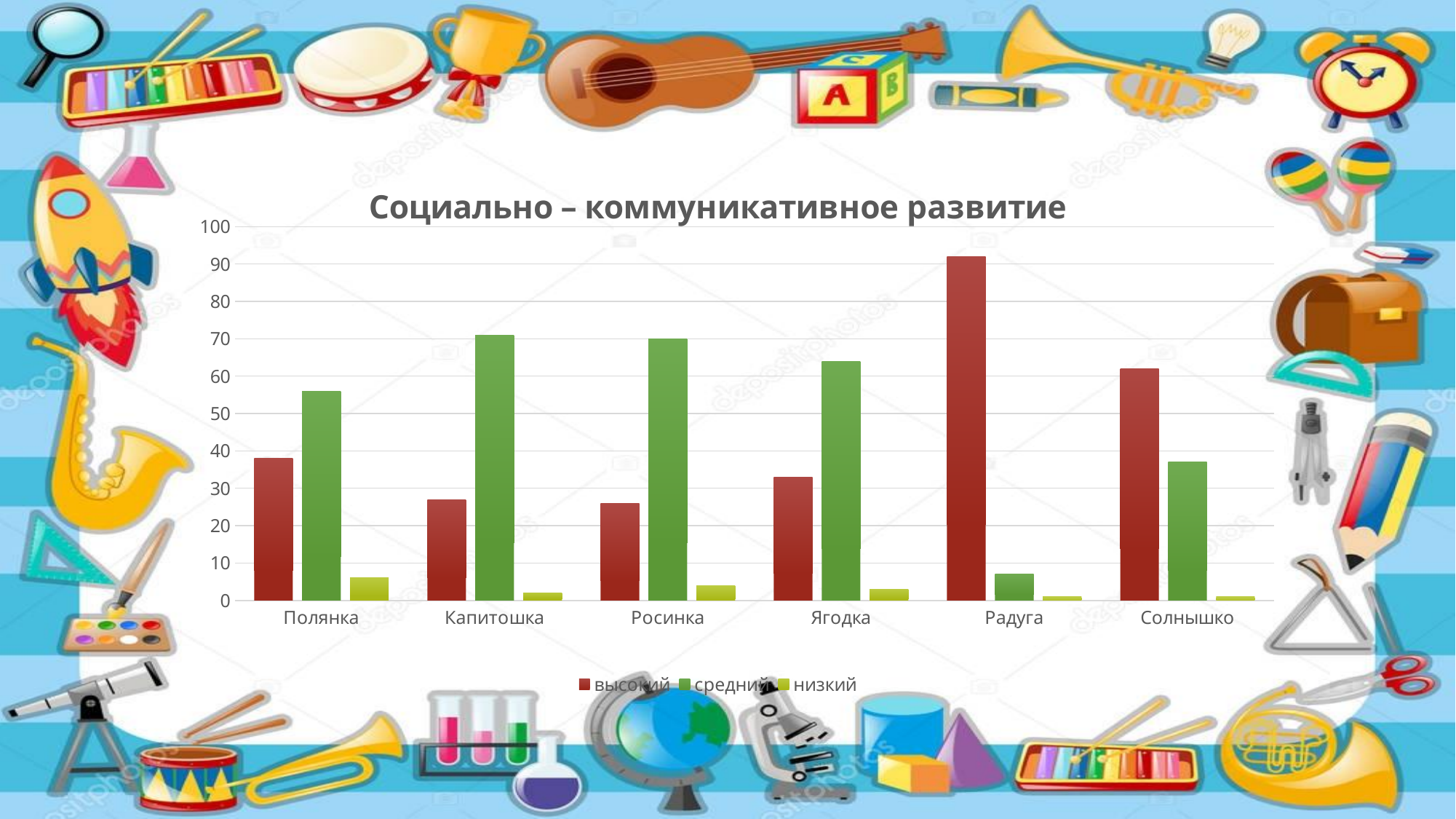
Which category has the highest value for the series низкий? Полянка For Солнышко, which is larger: the value for высокий or the value for средний? высокий What is the title of the chart? Социально – коммуникативное развитие Is the value for высокий in Капитошка greater or less than 30? less How many series does the legend list? 3 Is the value for высокий in Радуга greater or less than 80? greater Which series is shown in red in the legend? высокий What kind of chart is shown on the slide? bar chart Which category has the lowest value for the series средний? Радуга Is the value for средний in Полянка greater or less than 50? greater How many categories are shown on the x axis? 6 Which category has the highest value for the series высокий? Радуга